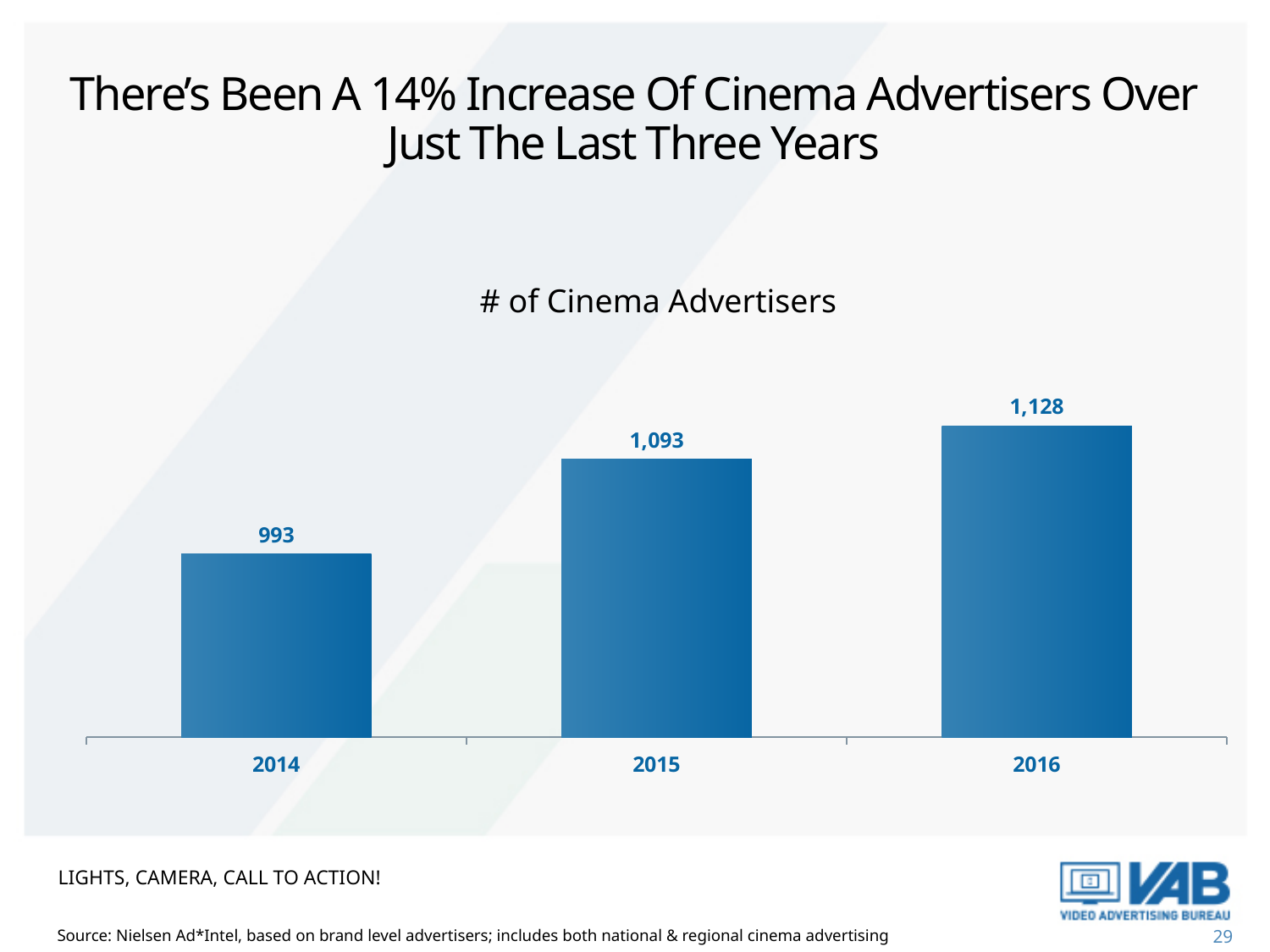
What is the number of cinema advertisers in 2015? 1,093 What is the number of cinema advertisers in 2014? 993 Do the values rise or fall from 2014 to 2016? Rise What is the difference in the number of cinema advertisers between 2016 and 2014? 135 Which year has more cinema advertisers, 2015 or 2016? 2016 What kind of chart is shown on the slide? Bar chart Which year has the lowest number of cinema advertisers? 2014 How many years are shown on the chart? 3 What is the title of the chart? # of Cinema Advertisers Which year has the highest number of cinema advertisers? 2016 What is the difference in the number of cinema advertisers between 2015 and 2014? 100 What is the number of cinema advertisers in 2016? 1,128